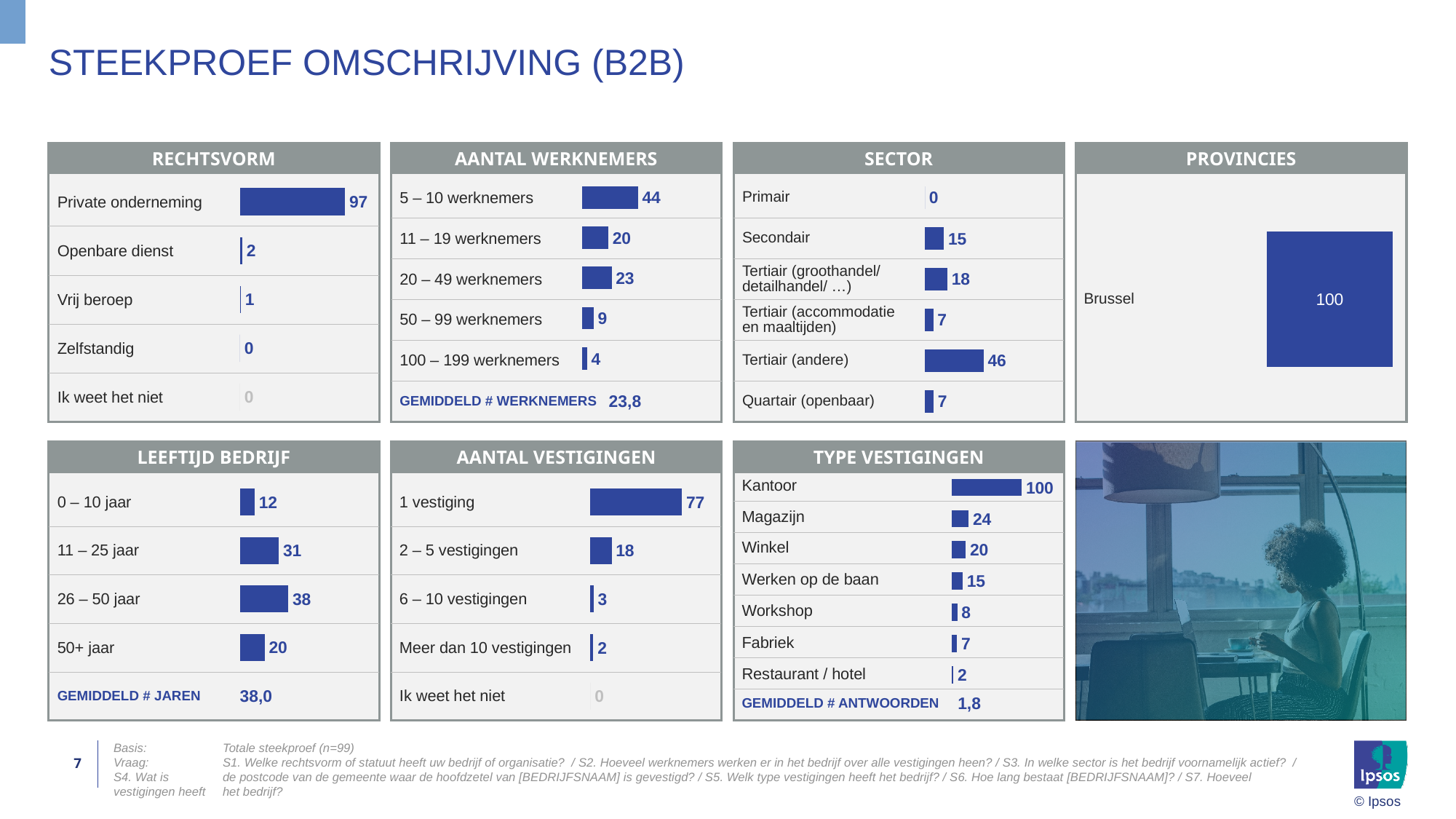
In the LEEFTIJD BEDRIJF chart, which category has the highest value? 26 – 50 jaar In the SECTOR chart, what is the value for Tertiair (andere)? 46 In the PROVINCIES chart, what is the value for Brussel? 100 In the SECTOR chart, which is larger: Secondair or Tertiair (groothandel/ detailhandel/ …)? Tertiair (groothandel/ detailhandel/ …) In the TYPE VESTIGINGEN chart, which category has the lowest value? Restaurant / hotel In the TYPE VESTIGINGEN chart, what is the difference between the values for Magazijn and Winkel? 4 In the RECHTSVORM chart, what is the value for Private onderneming? 97 In the LEEFTIJD BEDRIJF chart, how many categories are shown? 4 What kind of chart is the AANTAL WERKNEMERS chart? Bar chart In the AANTAL WERKNEMERS chart, which category has the highest value? 5 – 10 werknemers In the AANTAL WERKNEMERS chart, what is the difference between the values for 20 – 49 werknemers and 11 – 19 werknemers? 3 In the AANTAL VESTIGINGEN chart, what is the value for 1 vestiging? 77